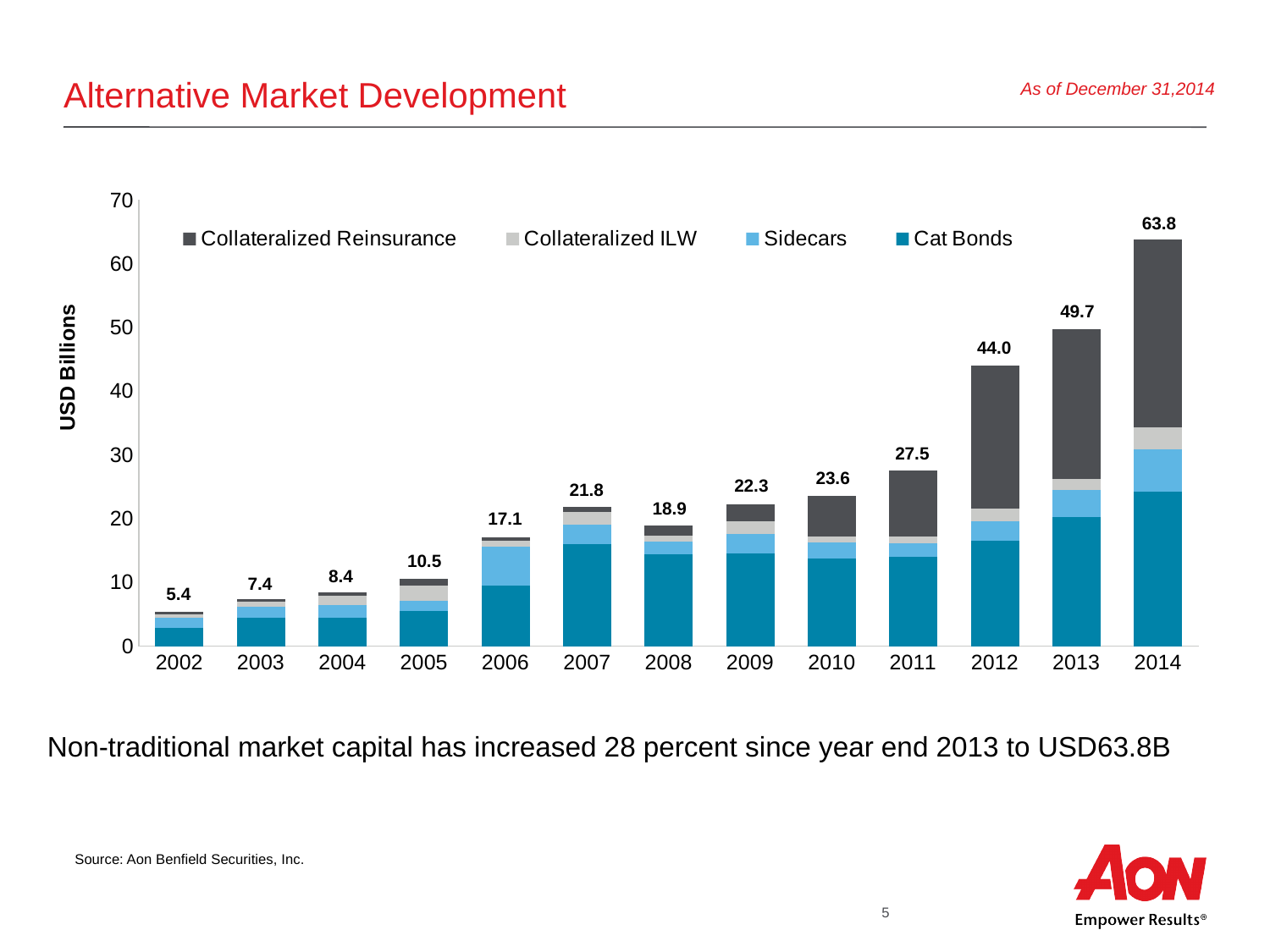
What is the total value shown for 2014? 63.8 Is the Cat Bonds value for 2014 greater or less than 20? greater What is the label on the y axis? USD Billions Which year has the highest total value? 2014 What is the total value shown for 2008? 18.9 How many years are shown on the x axis? 13 What is the difference between the total for 2014 and the total for 2013? 14.1 Which year has the lowest total value? 2002 Which year has the larger total, 2007 or 2008? 2007 What kind of chart is shown on the slide? Stacked bar chart Do the total values generally rise or fall from 2002 to 2014? Rise How many series does the legend list? 4